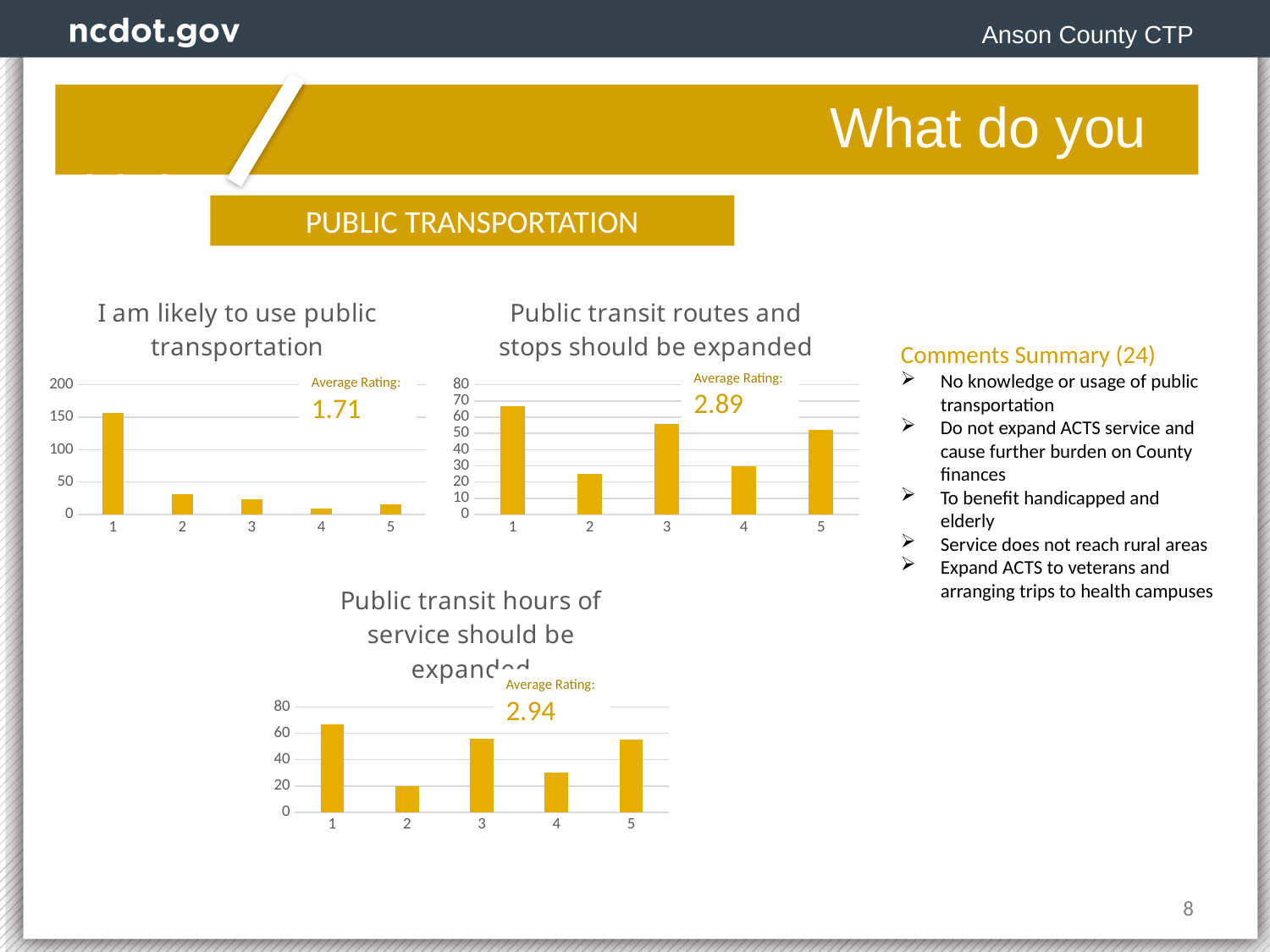
In the 'Public transit hours of service should be expanded' chart, which is larger, the value for rating 1 or the value for rating 2? rating 1 In the 'I am likely to use public transportation' chart, which rating category has the highest bar? 1 How many rating categories are shown on the x axis of the 'Public transit routes and stops should be expanded' chart? 5 What average rating is printed on the 'Public transit hours of service should be expanded' chart? 2.94 What kind of chart is the 'I am likely to use public transportation' chart? bar chart In the 'Public transit hours of service should be expanded' chart, is the value for rating 4 greater or less than 40? less In the 'Public transit routes and stops should be expanded' chart, is the value for rating 1 greater or less than 60? greater In the 'Public transit routes and stops should be expanded' chart, which rating category has the lowest bar? 2 In the 'Public transit routes and stops should be expanded' chart, which rating category has the highest bar? 1 In the 'I am likely to use public transportation' chart, which rating category has the lowest bar? 4 In the 'I am likely to use public transportation' chart, is the value for rating 1 greater or less than 100? greater